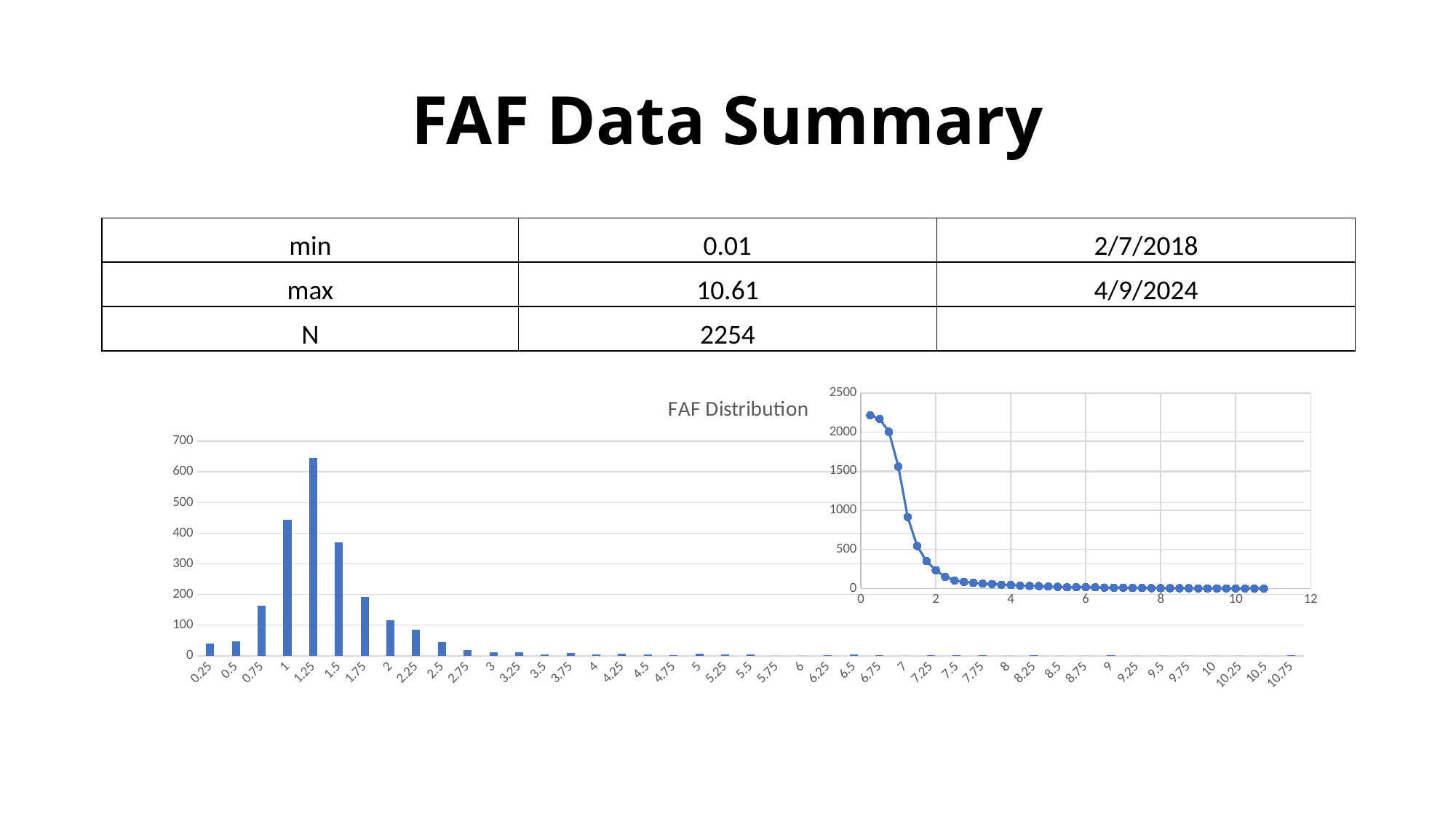
In the 'FAF Distribution' bar chart, is the value for 0.25 greater or less than 100? less In the 'FAF Distribution' bar chart, is the value for 1.5 greater or less than 400? less What kind of chart is the chart on the right of the slide? line chart In the 'FAF Distribution' bar chart, is the value for 1 greater or less than 400? greater In the line chart on the right, do the values rise or fall as the x axis increases? fall In the 'FAF Distribution' bar chart, which category has the highest bar? 1.25 What is the title of the bar chart on the left? FAF Distribution In the 'FAF Distribution' bar chart, which is larger, the value for 0.75 or the value for 2? 0.75 In the 'FAF Distribution' bar chart, which is larger, the value for 1 or the value for 1.5? 1 What kind of chart is the chart on the left titled 'FAF Distribution'? bar chart